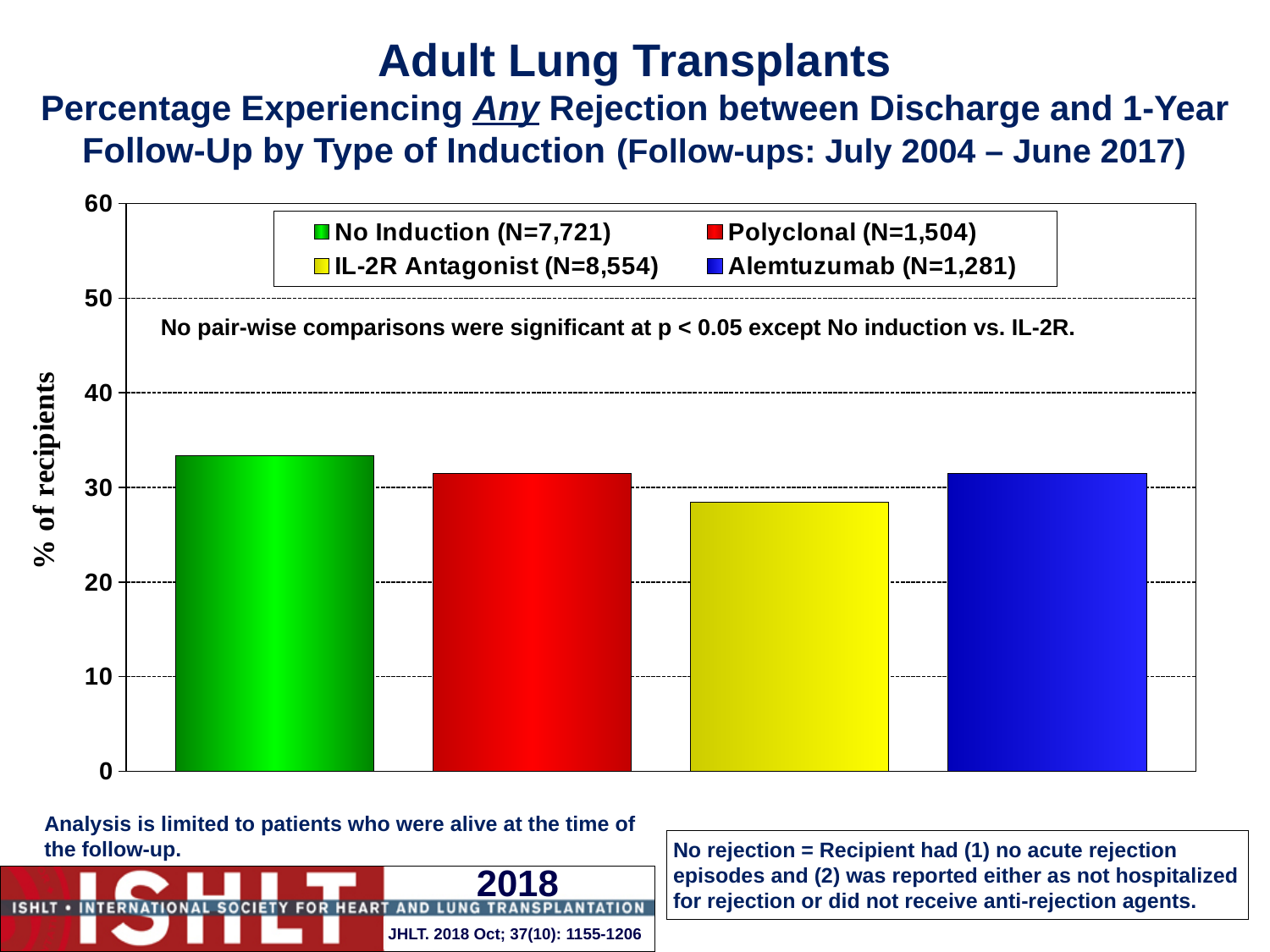
How many bars are plotted in the chart? 4 Which induction type has the highest percentage of recipients experiencing any rejection? No Induction Which induction type has the lowest percentage of recipients experiencing any rejection? IL-2R Antagonist How many series does the legend list? 4 Which is larger, the value for No Induction or the value for IL-2R Antagonist? No Induction Is the value for No Induction greater or less than 30? greater According to the legend, what is the N for the IL-2R Antagonist group? 8,554 What is the label on the y axis of the chart? % of recipients Is the value for Alemtuzumab greater or less than 40? less What kind of chart is shown on the slide? bar chart Is the value for IL-2R Antagonist greater or less than 30? less